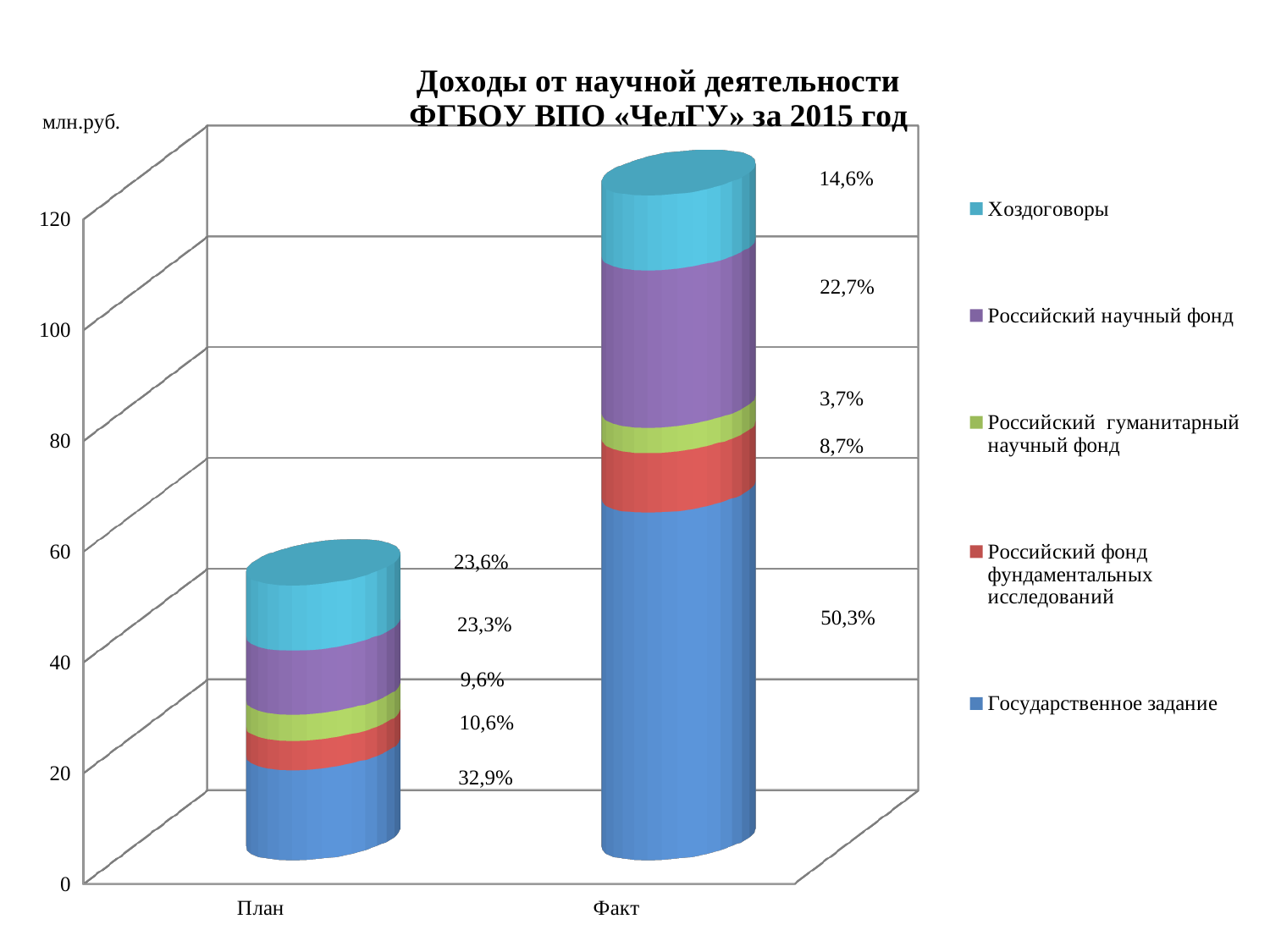
How many series does the chart's legend list? 5 What percentage label is shown for Российский научный фонд in the Факт bar? 22,7% Is the total height of the План bar greater or less than 80? less How many categories are shown on the x axis of the chart? 2 What percentage label is shown for Российский фонд фундаментальных исследований in the Факт bar? 8,7% What percentage label is shown for Государственное задание in the План bar? 32,9% What is the title of the chart? Доходы от научной деятельности ФГБОУ ВПО «ЧелГУ» за 2015 год What percentage label is shown for Хоздоговоры in the Факт bar? 14,6% Which category has the taller stacked bar, План or Факт? Факт Is the total height of the Факт bar greater or less than 100? greater What percentage label is shown for Российский гуманитарный научный фонд in the План bar? 9,6% What kind of chart is shown on the slide? bar chart